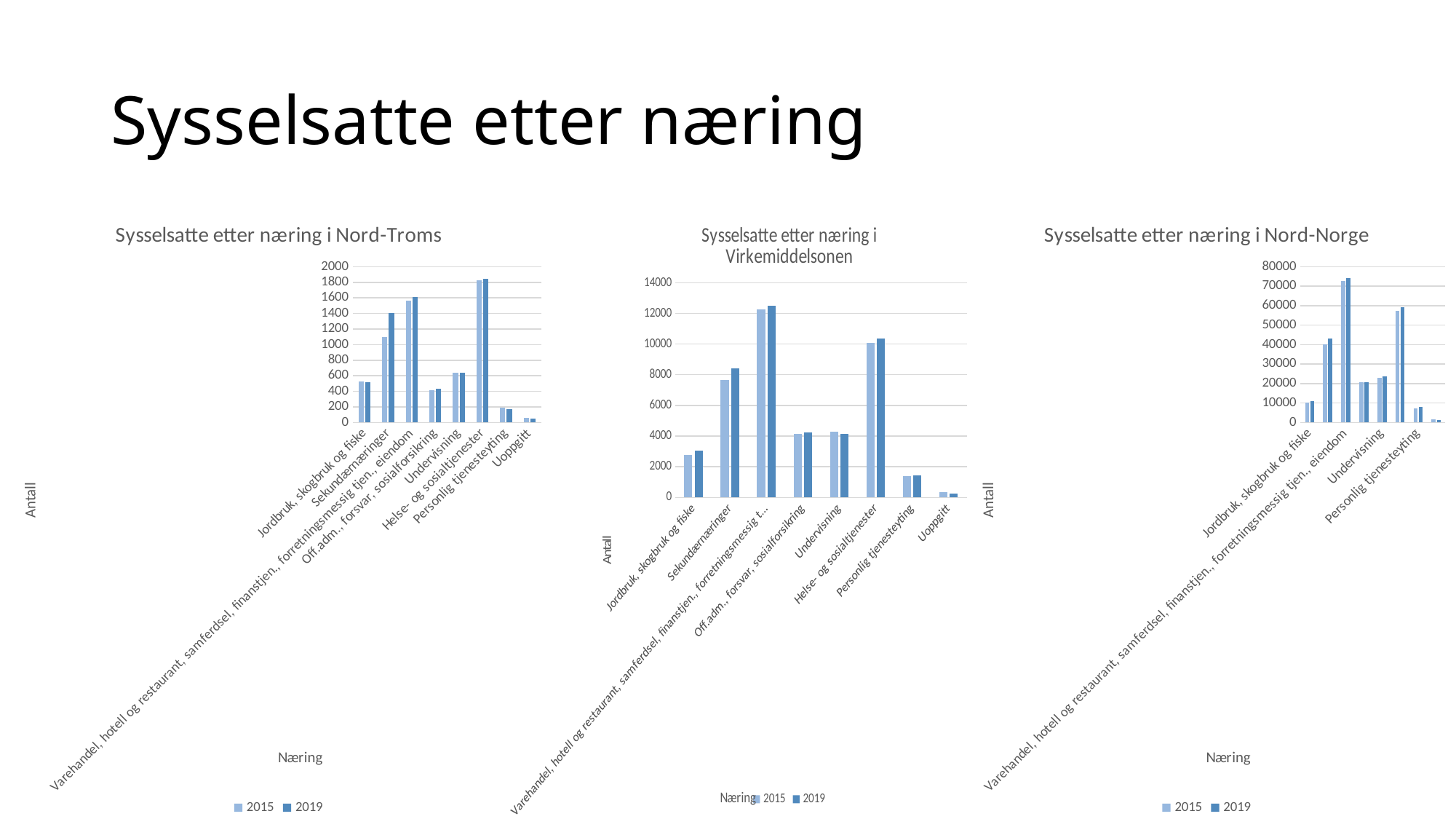
In the chart 'Sysselsatte etter næring i Nord-Troms', for Sekundærnæringer, which series is larger, 2015 or 2019? 2019 In the chart 'Sysselsatte etter næring i Virkemiddelsonen', which category has the lowest values? Uoppgitt In the chart 'Sysselsatte etter næring i Nord-Troms', which category has the highest values? Helse- og sosialtjenester What type of chart is 'Sysselsatte etter næring i Nord-Troms'? bar chart What are the two legend entries in the chart 'Sysselsatte etter næring i Nord-Norge'? 2015 and 2019 In the chart 'Sysselsatte etter næring i Virkemiddelsonen', is the 2019 value for Sekundærnæringer greater or less than 8000? greater In the chart 'Sysselsatte etter næring i Nord-Norge', is the 2015 value for Jordbruk, skogbruk og fiske greater or less than 20000? less In the chart 'Sysselsatte etter næring i Nord-Troms', which category has the lowest values? Uoppgitt In the chart 'Sysselsatte etter næring i Nord-Troms', how many series does the legend list? 2 In the chart 'Sysselsatte etter næring i Nord-Troms', is the 2015 value for Sekundærnæringer greater or less than 1000? greater In the chart 'Sysselsatte etter næring i Virkemiddelsonen', which category has the highest values? Varehandel, hotell og restaurant, samferdsel, finanstjen., forretningsmessig tjen., eiendom In the chart 'Sysselsatte etter næring i Nord-Troms', how many categories are shown on the x axis? 8